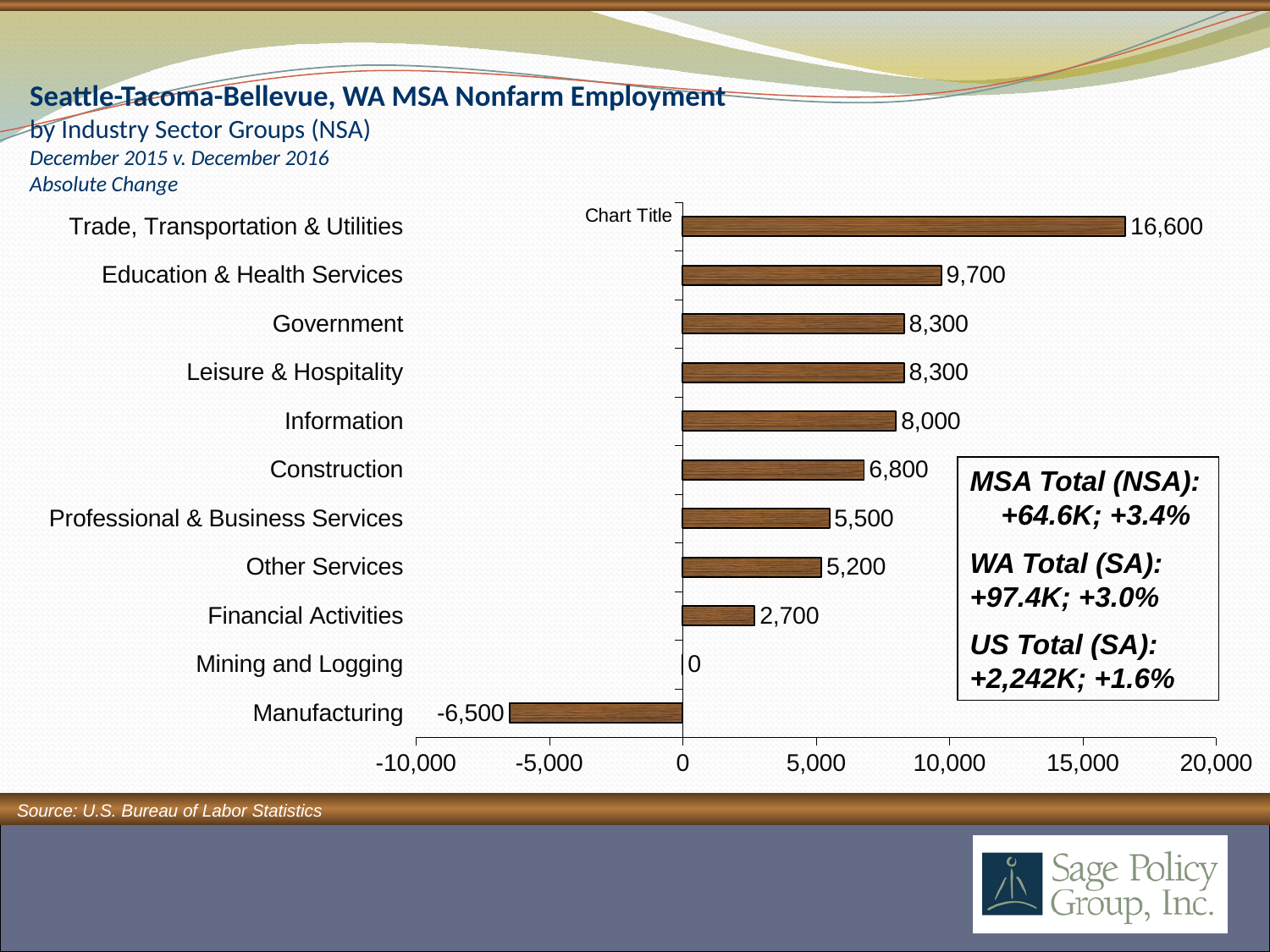
How many industry sector groups are shown in the chart? 11 Is the value for Information greater or less than 5,000? greater What is the value for Manufacturing? -6,500 Which is larger, the value for Construction or the value for Professional & Business Services? Construction Which industry sector has the lowest value? Manufacturing According to the text box on the chart, what is the MSA Total (NSA) change? +64.6K; +3.4% What is the difference between the values for Education & Health Services and Government? 1,400 What is the value for Financial Activities? 2,700 What is the value for Trade, Transportation & Utilities? 16,600 What kind of chart is shown on the slide? bar chart What is the value for Mining and Logging? 0 Which industry sector has the highest value? Trade, Transportation & Utilities